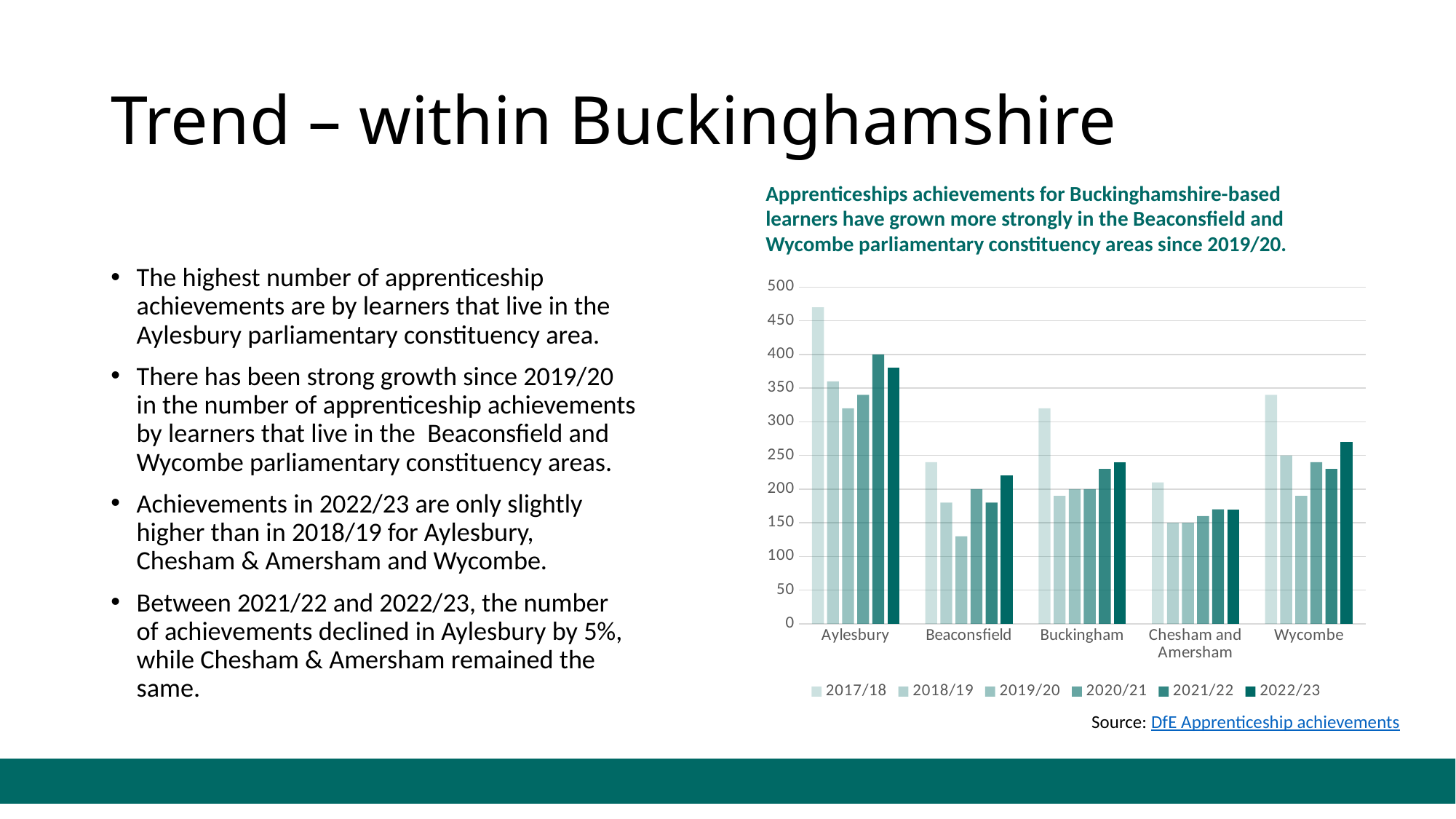
Which year is the first entry in the chart's legend? 2017/18 Do the values for Beaconsfield rise or fall from 2017/18 to 2019/20? fall Is the value for Aylesbury in 2017/18 greater or less than 450? greater Which constituency has the lowest value for 2022/23? Chesham and Amersham Is the value for Wycombe in 2017/18 greater or less than 300? greater How many series does the chart's legend list? 6 How many parliamentary constituency areas are shown on the x axis of the chart? 5 What kind of chart is shown on the slide? bar chart Which constituency has the highest value for 2017/18? Aylesbury For Aylesbury, which year has the larger value: 2021/22 or 2022/23? 2021/22 Which is larger for 2022/23: Wycombe or Buckingham? Wycombe Is the value for Beaconsfield in 2019/20 greater or less than 150? less